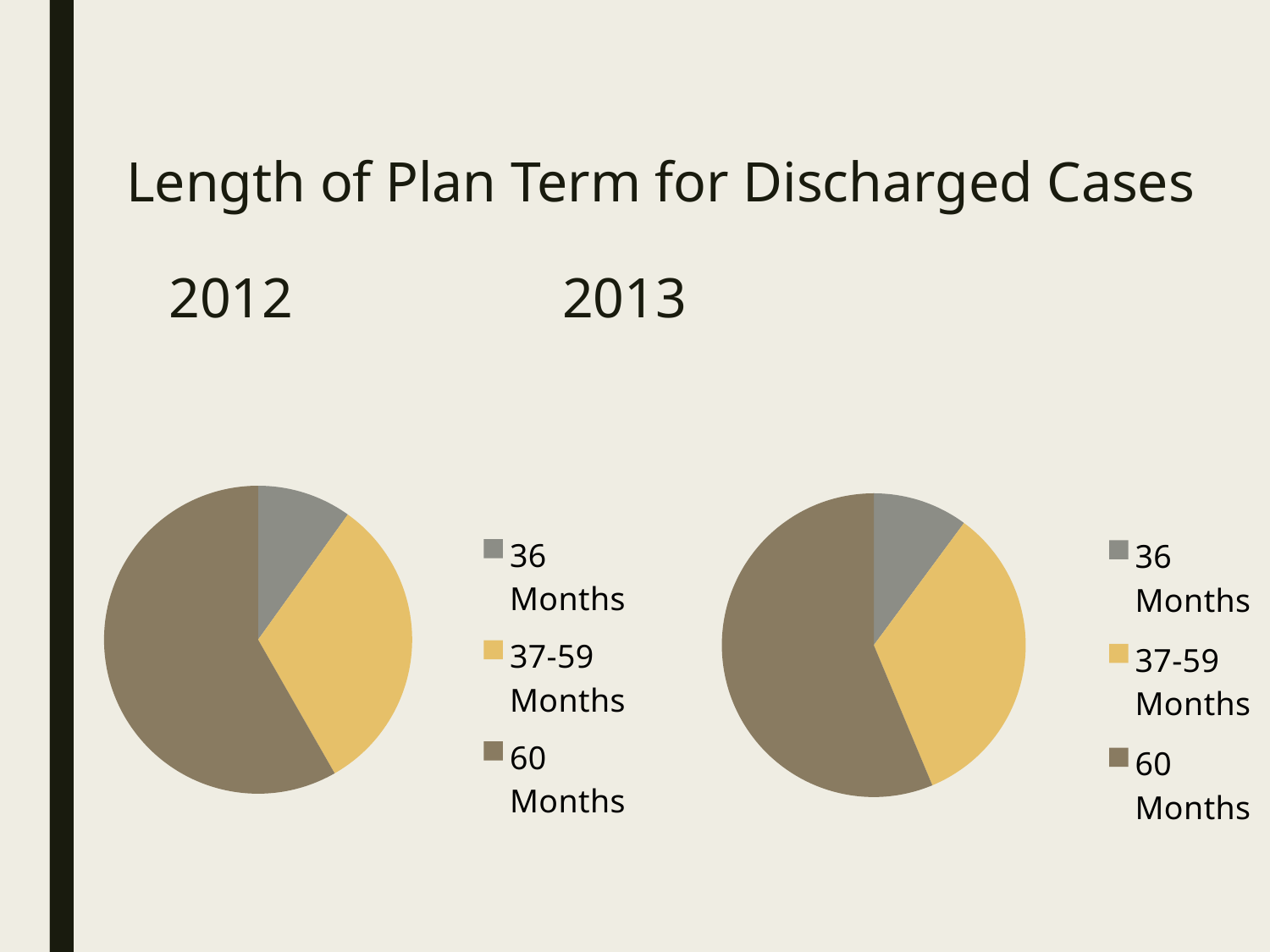
In the 2013 pie chart, which colour represents the 37-59 Months category? yellow In the 2012 pie chart, which plan term category has the largest slice? 60 Months What is the title shown above the two pie charts? Length of Plan Term for Discharged Cases In the 2013 pie chart, which plan term category has the smallest slice? 36 Months In the 2012 pie chart, which slice is larger: 37-59 Months or 36 Months? 37-59 Months In the 2013 pie chart, which slice is larger: 60 Months or 37-59 Months? 60 Months What kind of chart is the 2013 chart? pie chart How many entries does the legend of the 2013 pie chart list? 3 How many slices does the 2012 pie chart have? 3 In the 2013 pie chart, which plan term category has the largest slice? 60 Months In the 2012 pie chart, which plan term category has the smallest slice? 36 Months What kind of chart is the 2012 chart? pie chart